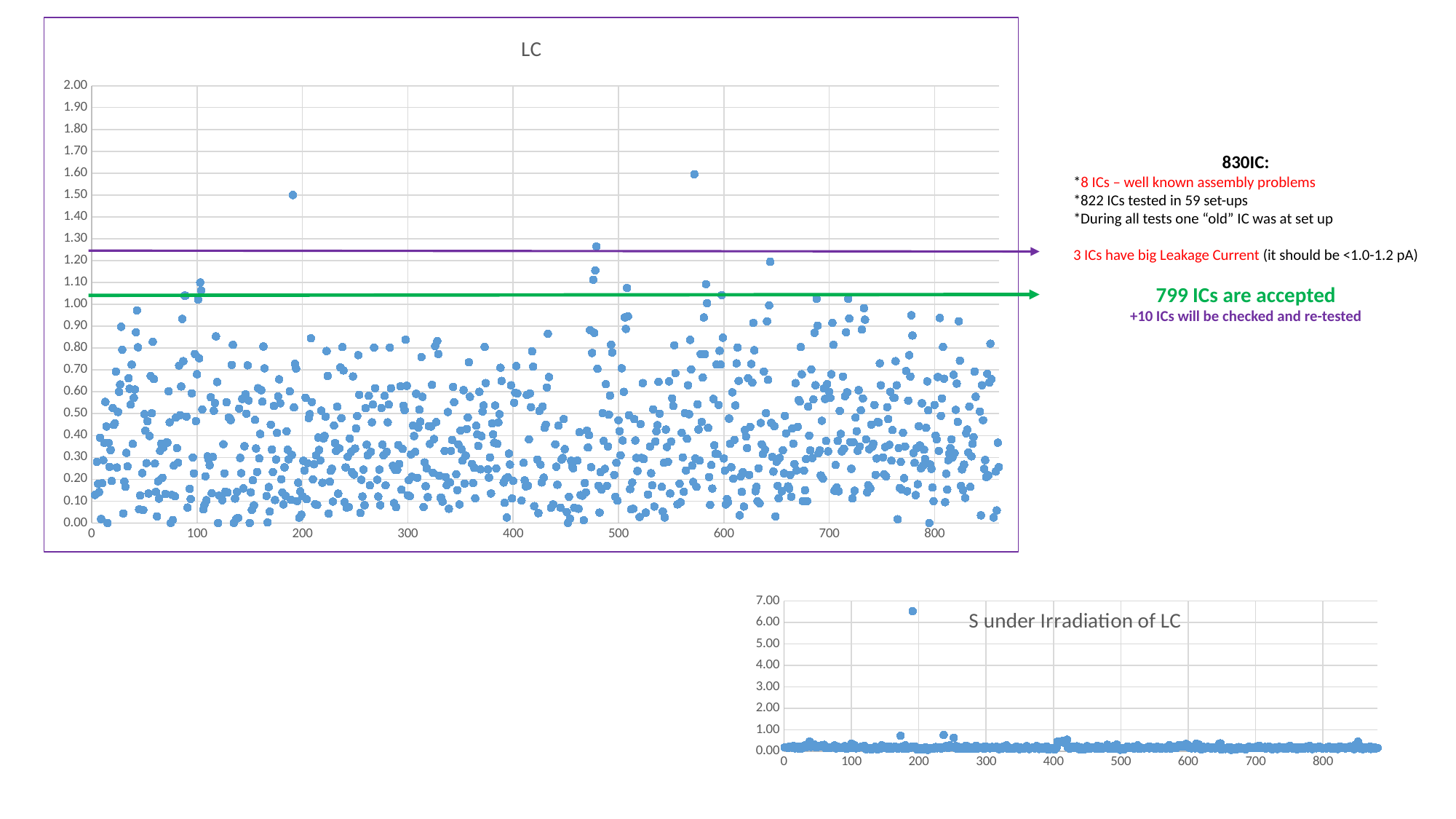
In the LC chart, which is higher: the outlying point near x = 190 or the outlying point near x = 570? the point near x = 570 In the S under Irradiation of LC chart, is the highest plotted point greater or less than 6.00? greater In the S under Irradiation of LC chart, between which two x-axis ticks does the highest plotted point lie? 100 and 200 In the LC chart, what is the highest value shown on the y axis? 2.00 What kind of chart is the LC chart at the top of the slide? scatter chart In the S under Irradiation of LC chart, is the point near x = 240 greater or less than 1.00? less In the LC chart, is the highest plotted point greater or less than 1.50? greater What kind of chart is the chart at the bottom right of the slide? scatter chart In the LC chart, between which two x-axis ticks does the highest plotted point lie? 500 and 600 What is the title of the chart at the bottom right of the slide? S under Irradiation of LC